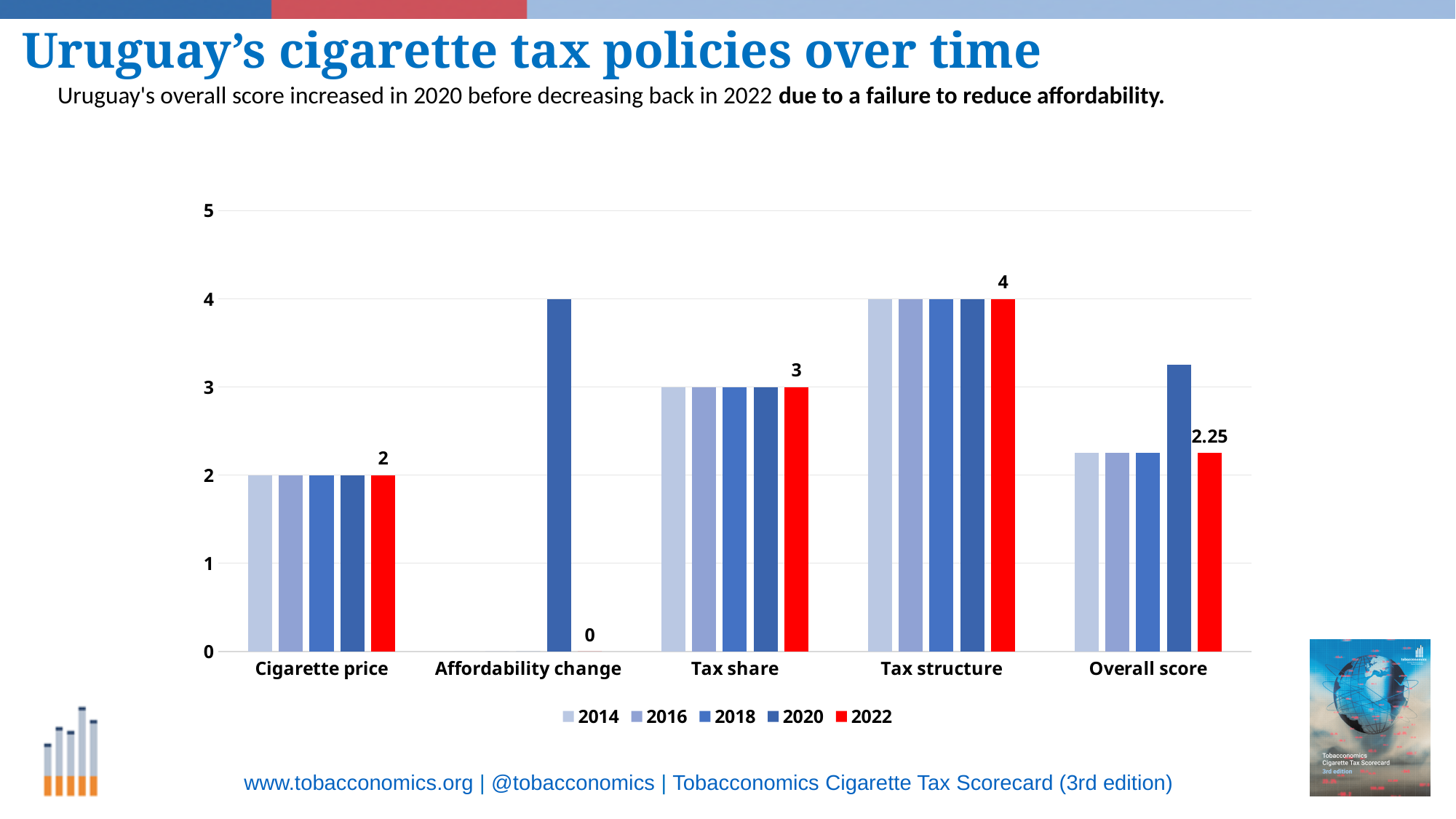
Which category has the highest 2022 value? Tax structure Is the 2020 value for Overall score greater or less than 3? greater For Overall score, which is larger: the 2020 bar or the 2022 bar? 2020 How many series does the legend list? 5 What is the difference between the 2022 values for Tax structure and Tax share? 1 What is the value of the 2022 bar for Tax structure? 4 Which category has the lowest 2022 value? Affordability change What kind of chart is shown on the slide? bar chart How many categories are shown on the x axis? 5 What is the value of the 2020 bar for Affordability change? 4 What is the value of the 2022 bar for Affordability change? 0 What is the value of the 2022 bar for Overall score? 2.25